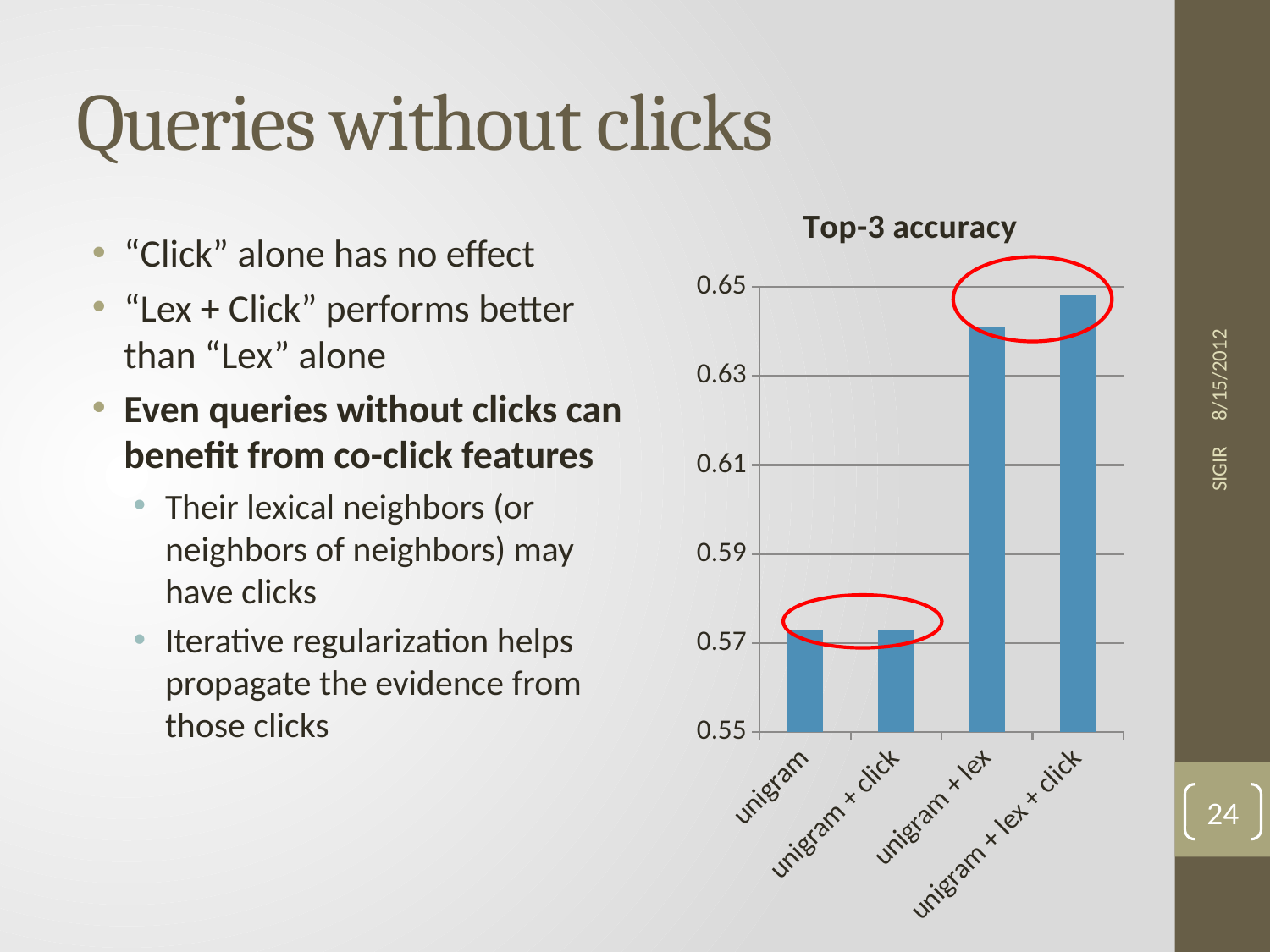
Is the value for unigram greater or less than 0.59? less What is the title of the chart? Top-3 accuracy What is the label of the leftmost category on the x axis? unigram Which is larger, the value for unigram + lex or the value for unigram + lex + click? unigram + lex + click Is the value for unigram + lex greater or less than 0.63? greater Which is larger, the value for unigram + click or the value for unigram + lex? unigram + lex What kind of chart is shown on the slide? bar chart How many categories are shown on the x axis of the chart? 4 Do the values generally rise or fall from left to right along the x axis? rise Which category has the highest Top-3 accuracy? unigram + lex + click Is the value for unigram + click greater or less than 0.61? less